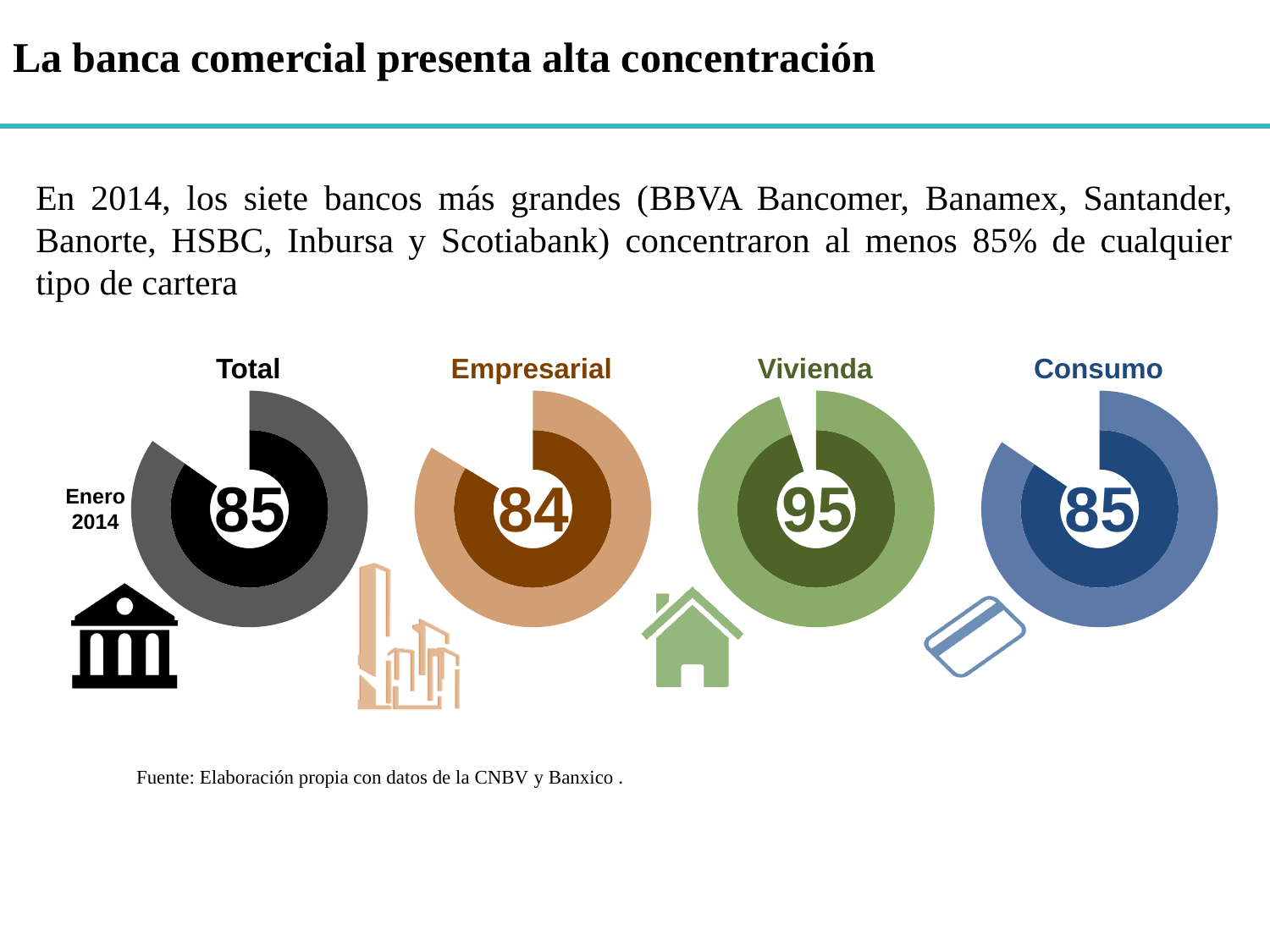
What date label appears to the left of the Total donut chart? Enero 2014 What value is shown in the centre of the Consumo donut chart? 85 What value is shown in the centre of the Vivienda donut chart? 95 What is the difference between the value in the Vivienda chart and the value in the Empresarial chart? 11 Which is larger, the value in the Vivienda chart or the value in the Consumo chart? Vivienda What value is shown in the centre of the Total donut chart? 85 What is the difference between the value in the Total chart and the value in the Empresarial chart? 1 How many donut charts are shown on the slide? 4 What kind of chart is used to show the Total, Empresarial, Vivienda and Consumo values? Donut (pie) chart What value is shown in the centre of the Empresarial donut chart? 84 Which of the four donut charts shows the highest value? Vivienda Which of the four donut charts shows the lowest value? Empresarial